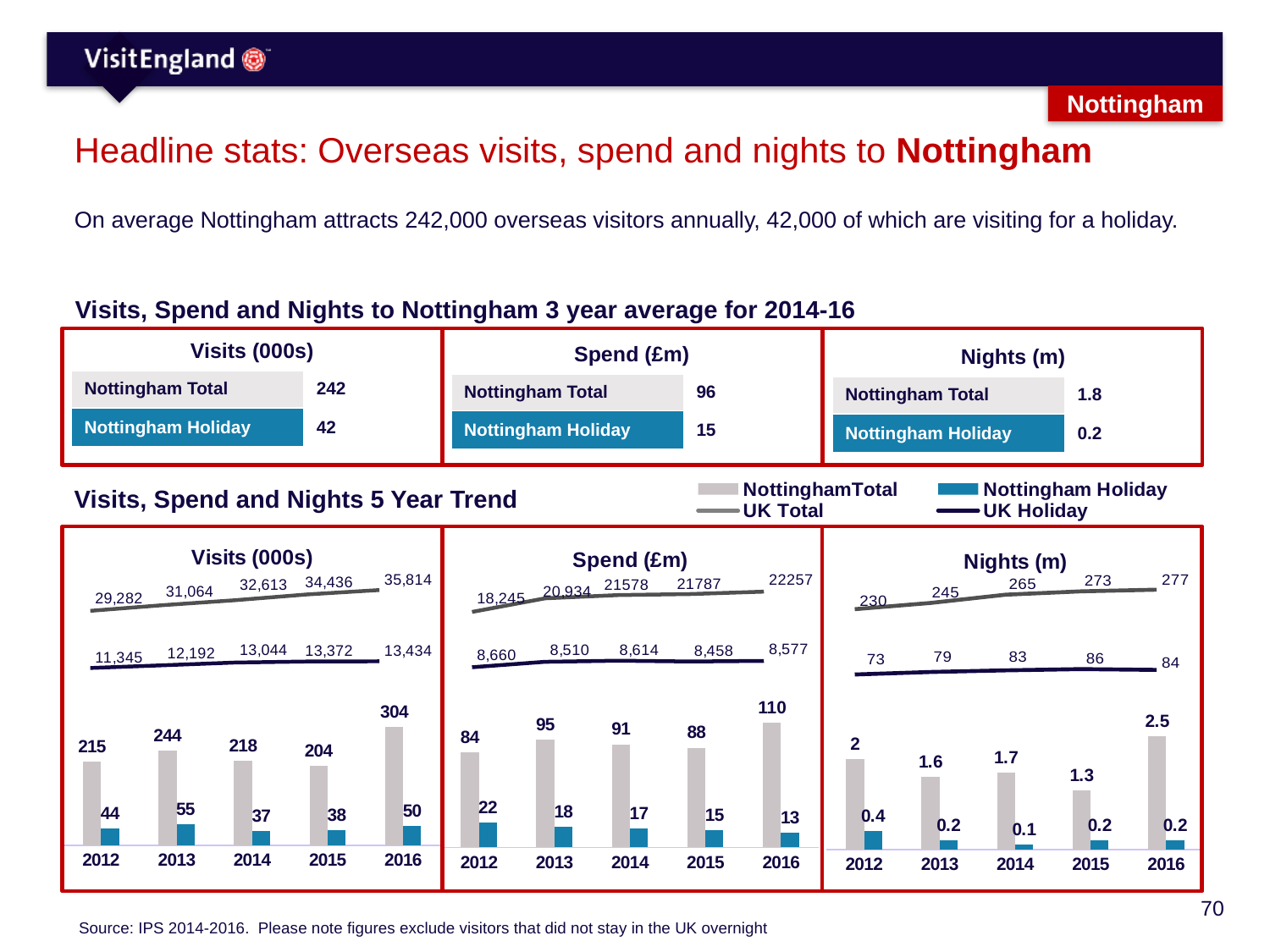
How many years are shown on the x axis of the Spend (£m) trend chart? 5 In the Visits (000s) trend chart, what is the UK Holiday value for 2012? 11,345 In the Spend (£m) trend chart, what is the Nottingham Holiday value for 2012? 22 In the Visits (000s) trend chart, which year has the lowest Nottingham Holiday value? 2014 In the Spend (£m) trend chart, what is the difference between the Nottingham Total values for 2016 and 2015? 22 In the Nights (m) trend chart, what is the UK Total value for 2014? 265 In the Visits (000s) trend chart, which year has the highest Nottingham Total value? 2016 In the Nights (m) trend chart, which is larger, the Nottingham Total value for 2013 or for 2015? 2013 In the Spend (£m) trend chart, does the Nottingham Holiday value rise or fall from 2012 to 2016? fall In the Nights (m) trend chart, what is the Nottingham Total value for 2016? 2.5 In the Visits (000s) trend chart, what is the Nottingham Total value for 2016? 304 How many series does the legend for the 5 Year Trend charts list? 4